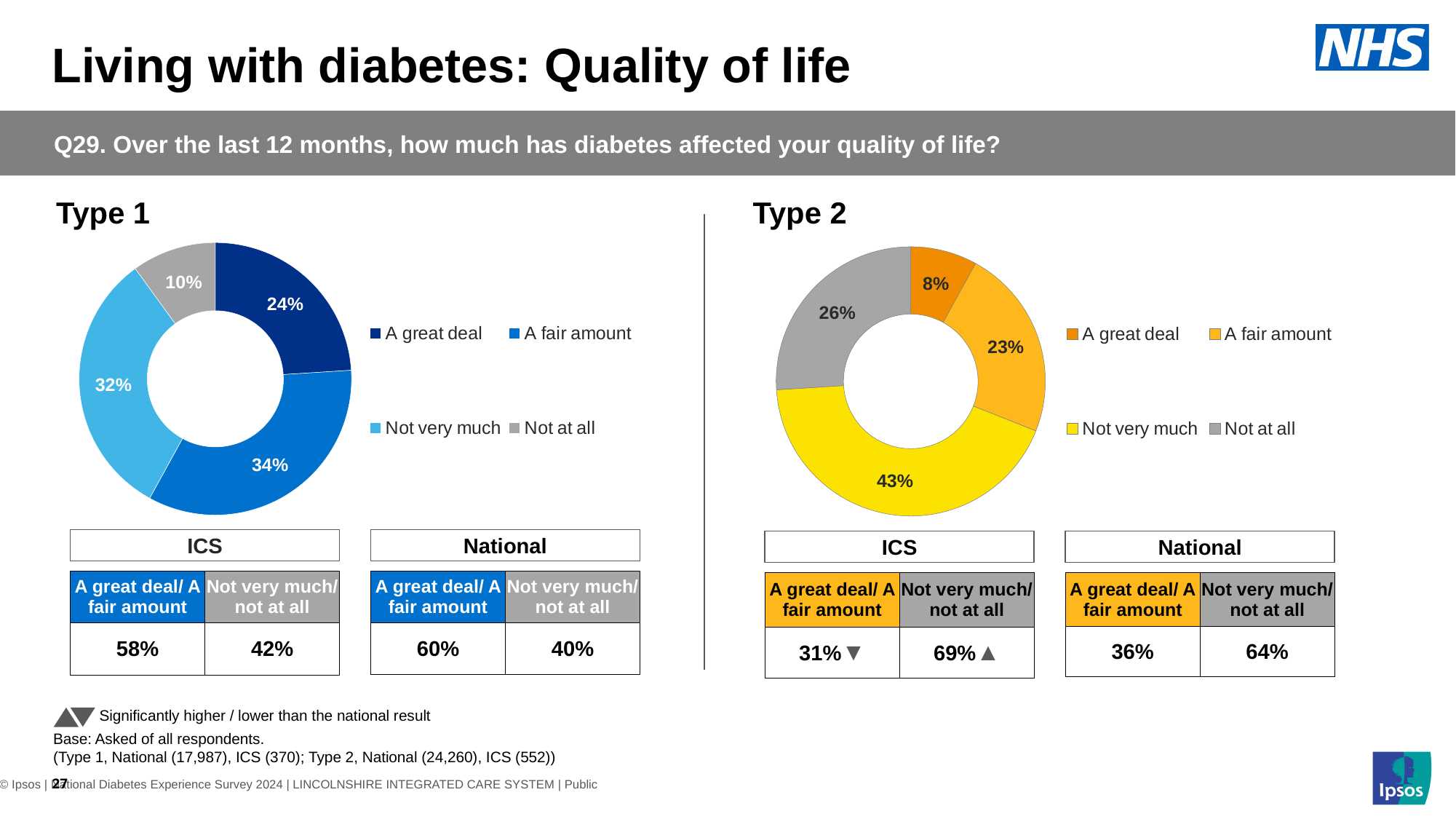
How many response categories are shown in the Type 2 chart? 4 In the Type 2 chart, what percentage of respondents said 'Not very much'? 43% In the Type 1 chart, what percentage of respondents said diabetes affected their quality of life 'A fair amount'? 34% In the Type 1 chart, what percentage of respondents said 'A great deal'? 24% What colour represents 'Not very much' in the Type 2 chart? Yellow In the Type 2 chart, what is the difference between the 'Not at all' share and the 'A great deal' share? 18 percentage points In the Type 1 chart, which response category has the smallest share? Not at all What type of chart is used to show the Type 1 results? Doughnut (pie) chart In the Type 2 chart, which response category has the largest share? Not very much In the Type 1 chart, what is the combined share of 'A great deal' and 'A fair amount'? 58% In the Type 2 chart, what is the combined share of 'Not very much' and 'Not at all'? 69% In the Type 1 chart, which is larger: the share for 'A great deal' or the share for 'Not very much'? Not very much